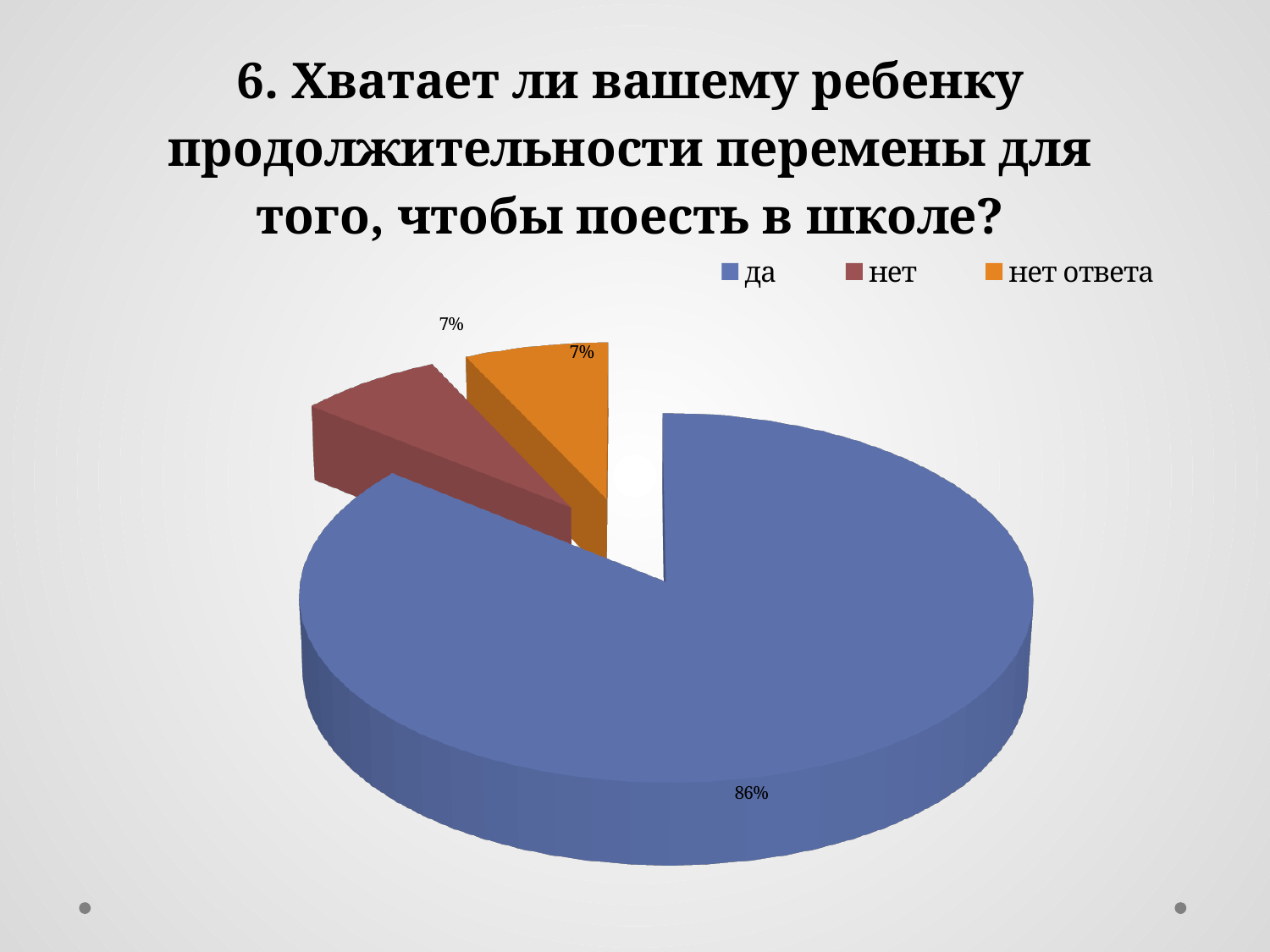
What is the title of the chart on the slide? 6. Хватает ли вашему ребенку продолжительности перемены для того, чтобы поесть в школе? Which category has the largest slice of the pie? да How many entries does the legend list? 3 What is the combined share of "нет" and "нет ответа"? 14% What share of the pie does "нет ответа" have? 7% What kind of chart is shown on the slide? pie chart What share of the pie does "нет" have? 7% Which is larger, the share for "да" or the share for "нет ответа"? да Which colour represents "нет ответа" in the pie chart? orange What is the difference between the share for "да" and the share for "нет"? 79% How many slices does the pie chart have? 3 What share of the pie does "да" have? 86%